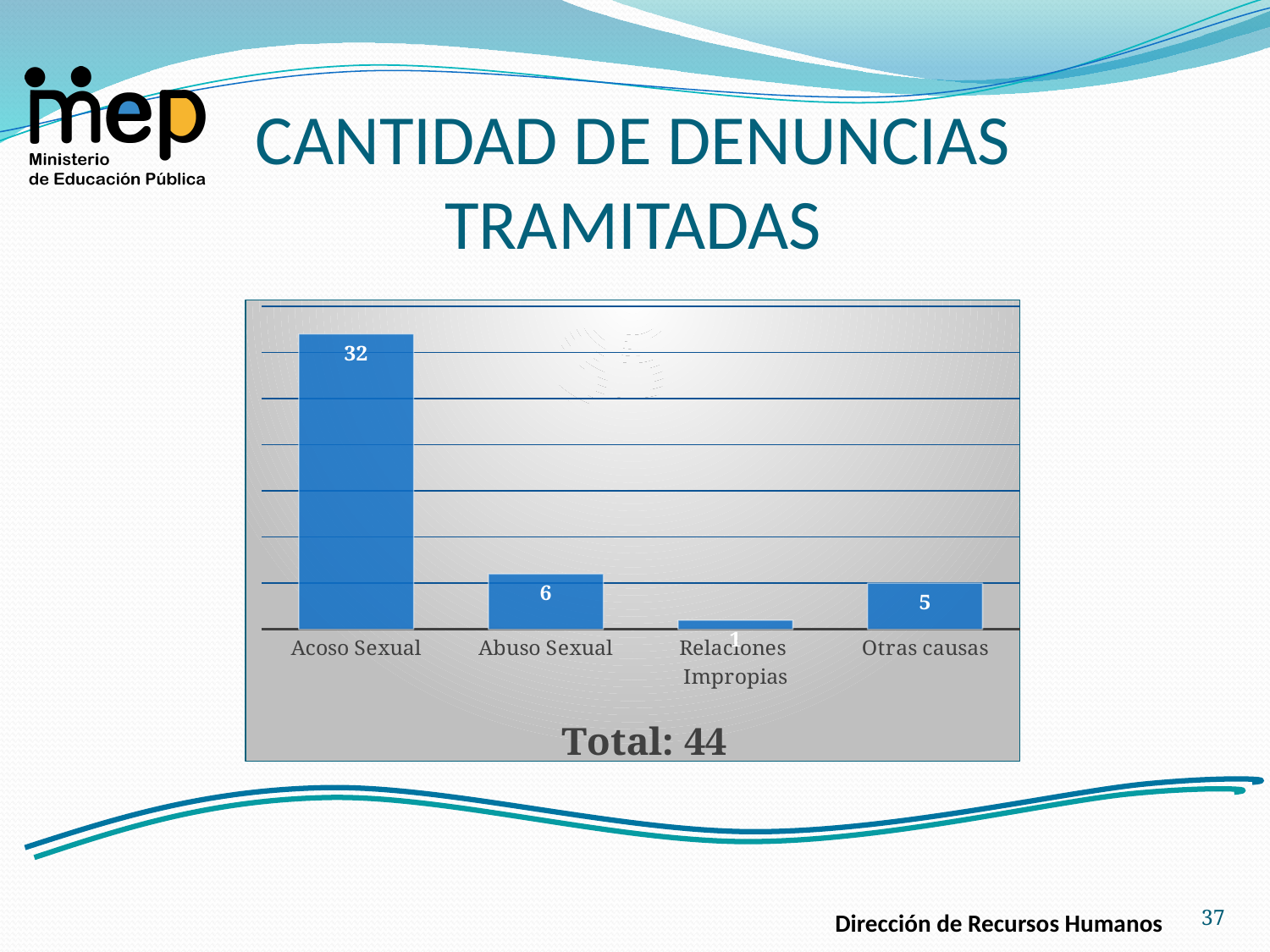
What is the value for Abuso Sexual? 6 What kind of chart is shown on the slide? Bar chart What total is printed below the chart? Total: 44 How many categories are shown on the x axis? 4 Which is larger, the value for Abuso Sexual or the value for Otras causas? Abuso Sexual What is the value for Acoso Sexual? 32 Which category has the lowest value? Relaciones Impropias What is the difference between the values for Acoso Sexual and Abuso Sexual? 26 What is the value for Relaciones Impropias? 1 What is the difference between the values for Abuso Sexual and Otras causas? 1 Which category has the highest value? Acoso Sexual What is the value for Otras causas? 5